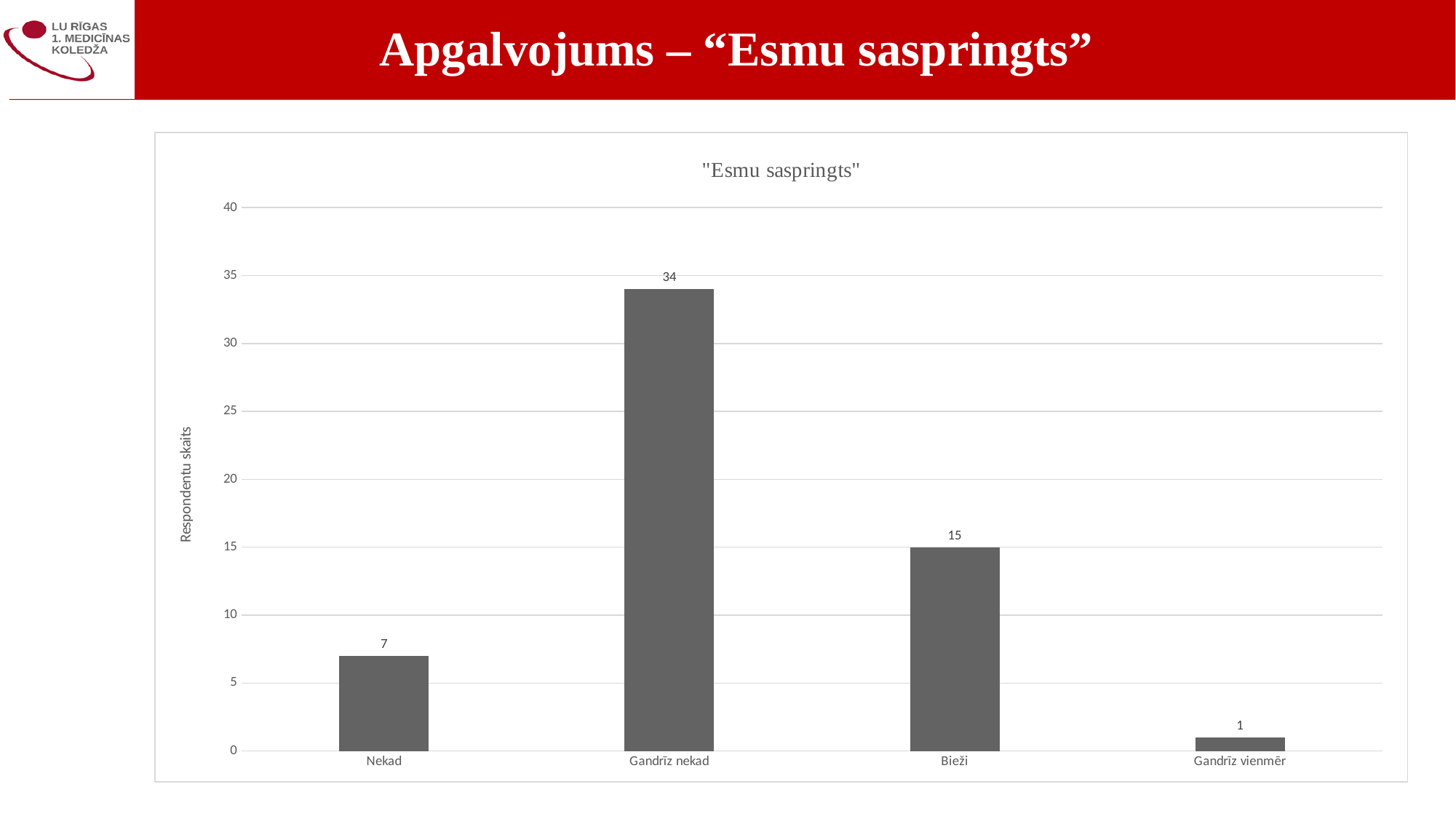
Is the value for Gandrīz nekad greater or less than 30? greater What is the value for Gandrīz vienmēr? 1 Which is larger, the value for Nekad or the value for Bieži? Bieži What is the difference between the values for Gandrīz nekad and Bieži? 19 What is the value for Gandrīz nekad? 34 What kind of chart is shown? bar chart What is the value for Bieži? 15 What is the value for Nekad? 7 Which category has the highest value? Gandrīz nekad What is the label of the vertical axis? Respondentu skaits Which category has the lowest value? Gandrīz vienmēr How many categories are shown on the x axis? 4